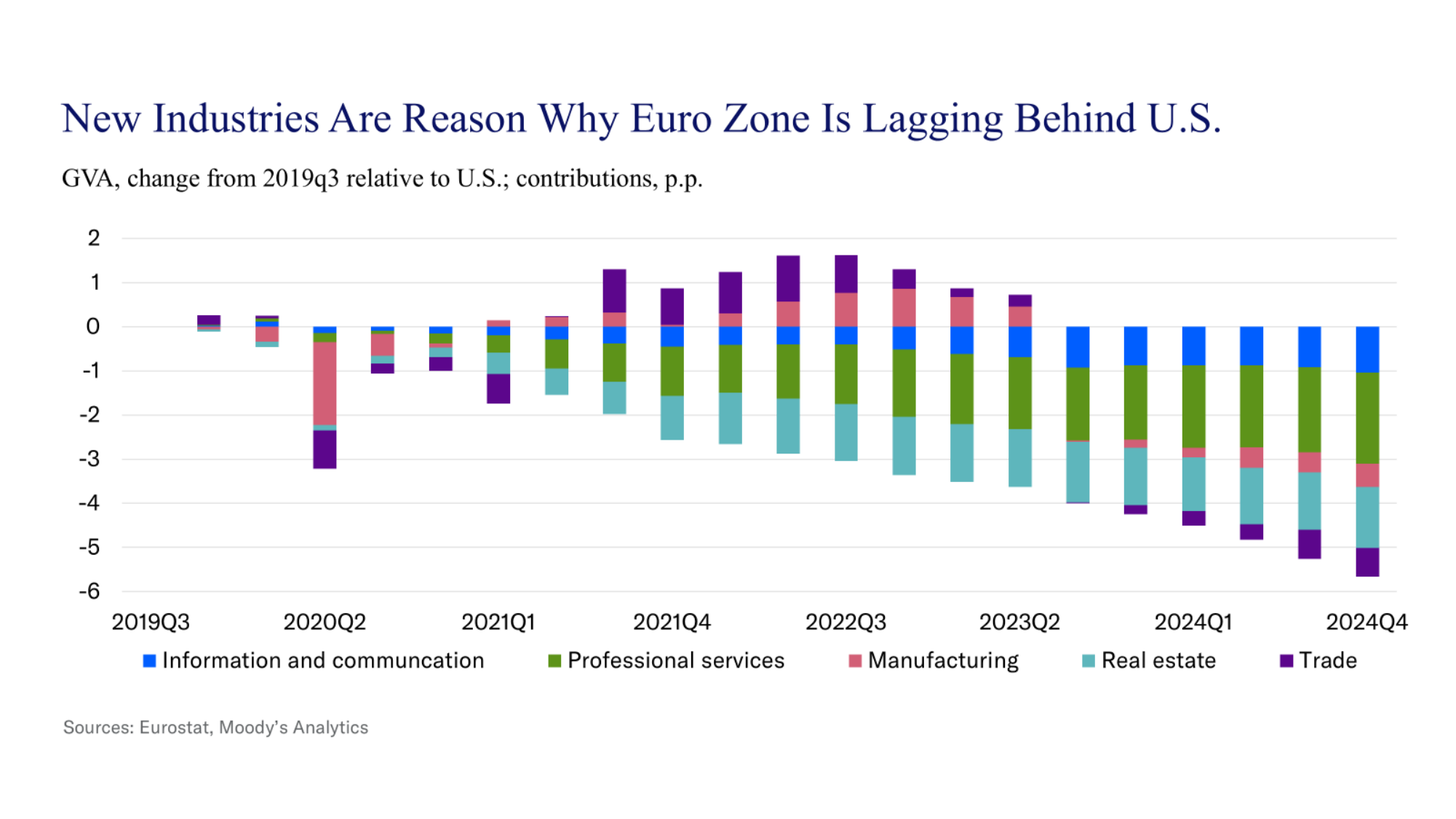
What is the title of the chart? New Industries Are Reason Why Euro Zone Is Lagging Behind U.S. Is the lowest point of the stacked bar for 2020Q2 greater or less than -3? less What kind of chart is shown on the slide? Stacked bar chart How many series does the legend list? 5 Is the lowest point of the stacked bar for 2024Q4 greater or less than -5? less Which bar reaches lower, 2024Q1 or 2024Q4? 2024Q4 Which series forms the bottom segment of the 2024Q4 bar? Trade Which series is shown in purple in the legend? Trade Does the lowest point of the stacked bars rise or fall from 2023Q2 to 2024Q4? fall Is the highest point of the stacked bar for 2022Q3 greater or less than 1? greater Which series has the largest negative contribution in the 2024Q4 bar? Professional services